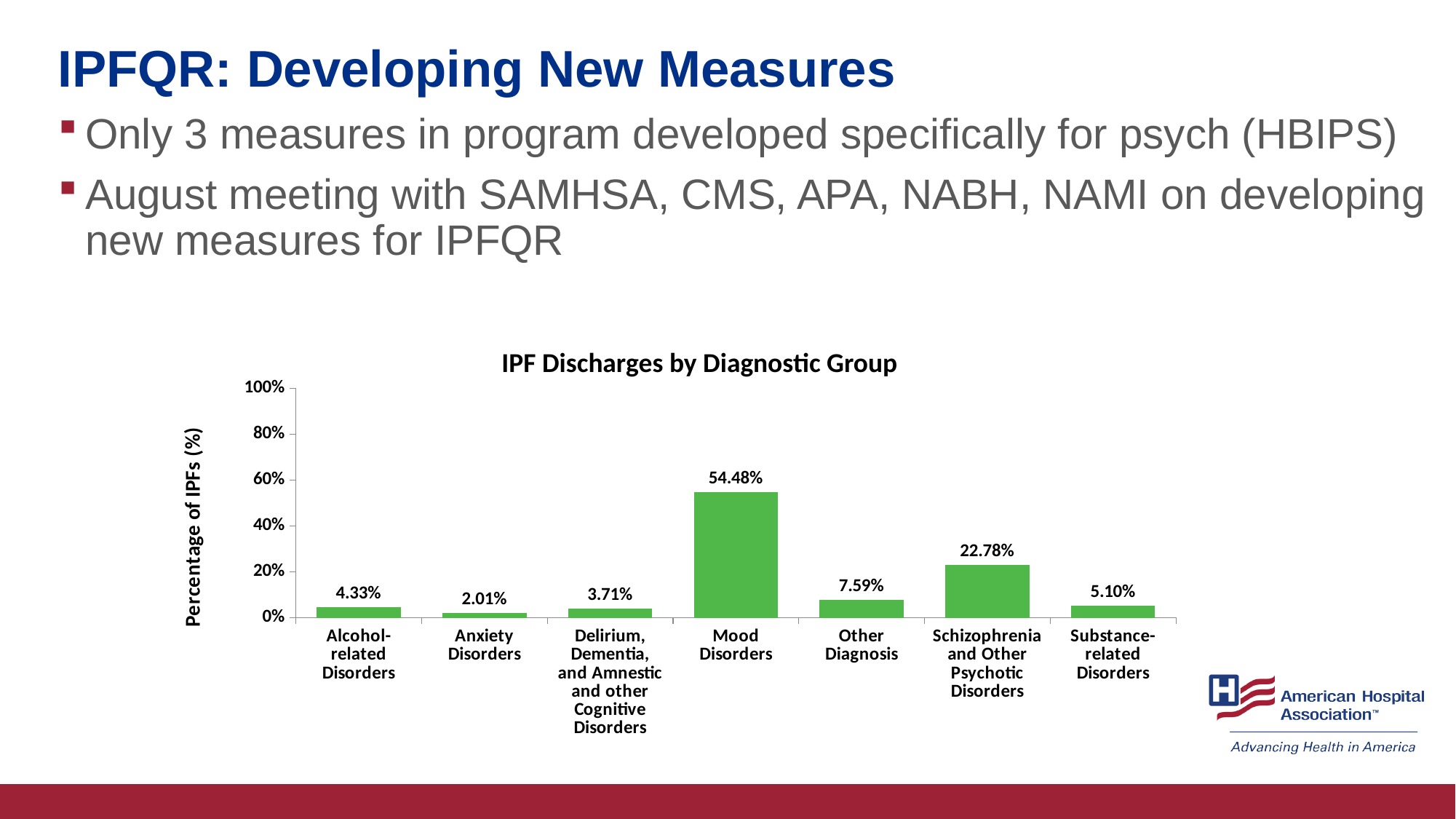
Is the value for Mood Disorders greater or less than 40%? greater What is the difference between the values for Mood Disorders and Schizophrenia and Other Psychotic Disorders? 31.70% Which is larger, the value for Other Diagnosis or the value for Alcohol-related Disorders? Other Diagnosis Which diagnostic group has the highest percentage of IPF discharges? Mood Disorders What is the value for Mood Disorders? 54.48% What is the value for Anxiety Disorders? 2.01% What is the value for Substance-related Disorders? 5.10% Which diagnostic group has the lowest percentage of IPF discharges? Anxiety Disorders What kind of chart is shown on the slide? Bar chart What is the title of the chart? IPF Discharges by Diagnostic Group What is the value for Schizophrenia and Other Psychotic Disorders? 22.78% How many diagnostic groups are shown in the chart? 7